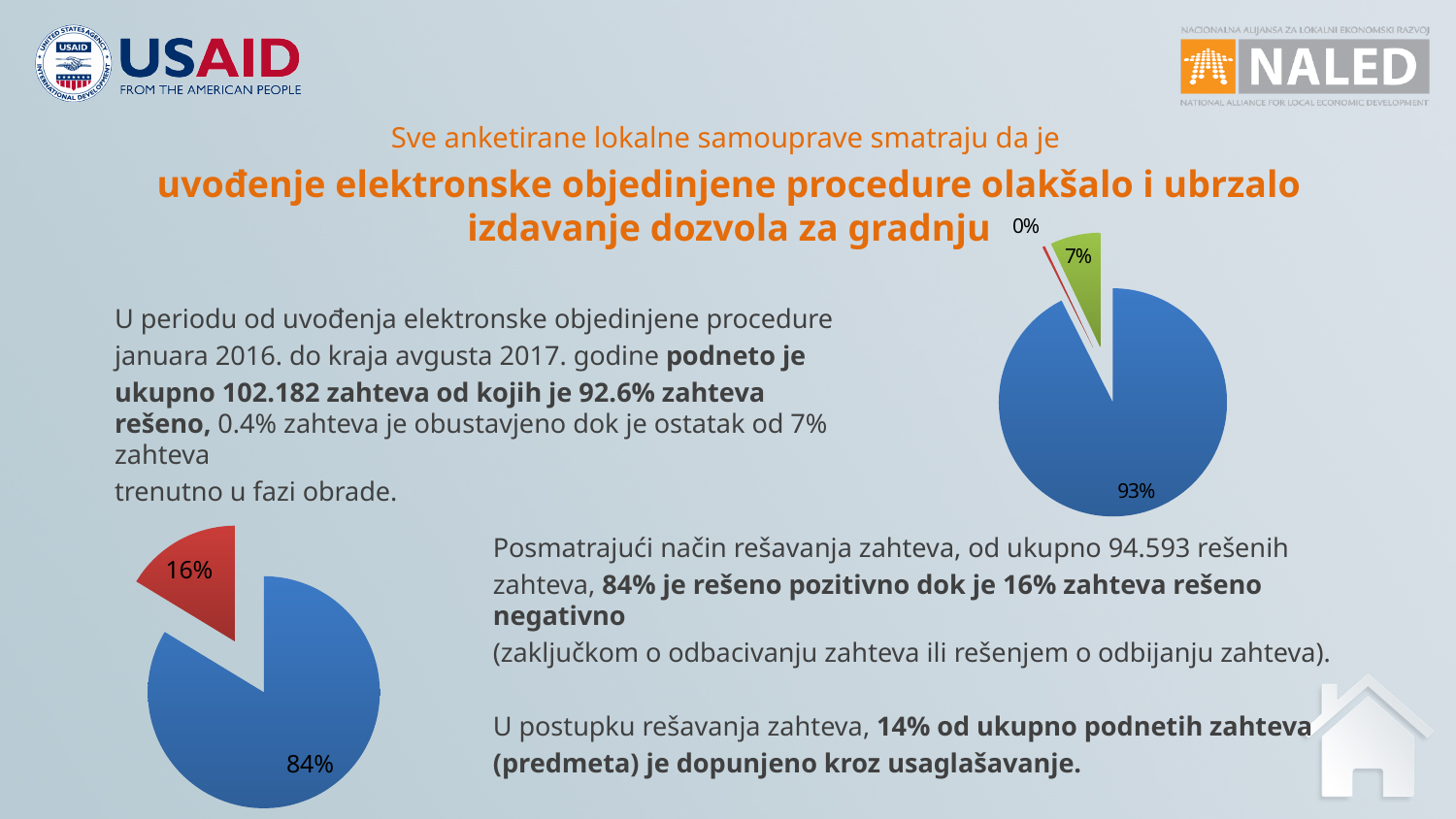
What kind of chart is the chart in the top-right of the slide? pie chart In the bottom-left pie chart, what percentage is shown for the red slice? 16% How many slices are labelled in the top-right pie chart? 3 In the top-right pie chart, what percentage is shown for the largest (blue) slice? 93% In the top-right pie chart, what percentage is shown for the green slice? 7% In the bottom-left pie chart, which slice is larger, the blue one or the red one? the blue one In the bottom-left pie chart, what percentage is shown for the blue slice? 84% In the top-right pie chart, what is the smallest percentage value labelled? 0% In the bottom-left pie chart, what is the difference in percentage points between the two slices? 68 In the top-right pie chart, what is the difference in percentage points between the 93% slice and the 7% slice? 86 What kind of chart is the chart in the bottom-left of the slide? pie chart How many pie charts are shown on the slide? 2